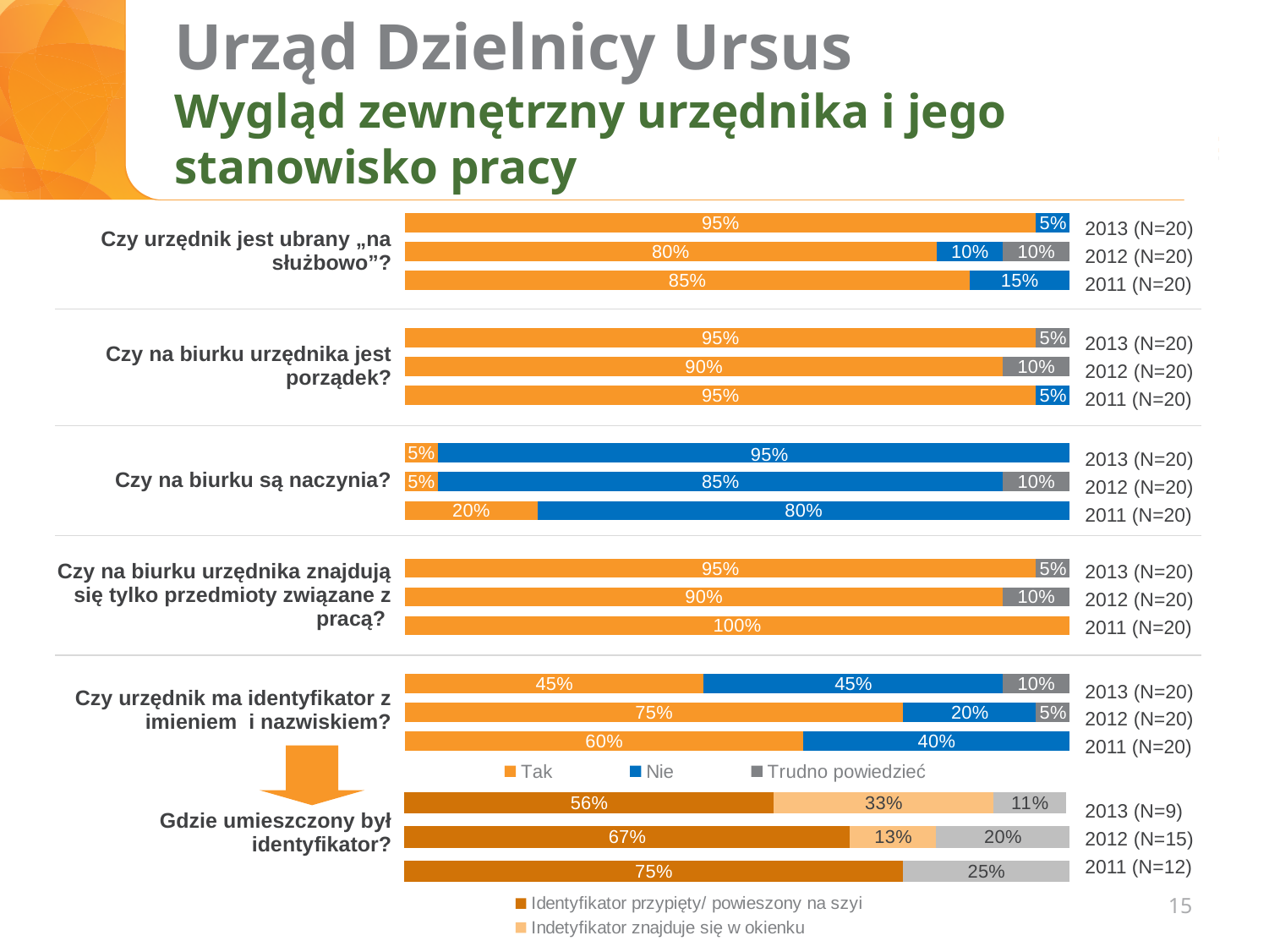
In the chart for "Gdzie umieszczony był identyfikator?", which year has the lowest value for "Identyfikator przypięty/ powieszony na szyi"? 2013 (N=9) In the chart for "Gdzie umieszczony był identyfikator?", what is the value for "Identyfikator przypięty/ powieszony na szyi" in 2012 (N=15)? 67% In the chart for "Czy urzędnik ma identyfikator z imieniem i nazwiskiem?", what is the difference between the "Tak" values for 2012 (N=20) and 2013 (N=20)? 30% In the chart for "Czy na biurku są naczynia?", which year has the highest "Tak" value? 2011 (N=20) How many series does the legend list for the "Czy urzędnik ma identyfikator z imieniem i nazwiskiem?" chart? 3 What kind of chart is used for "Czy na biurku urzędnika jest porządek?"? Stacked bar chart In the chart for "Czy urzędnik ma identyfikator z imieniem i nazwiskiem?", what is the "Nie" value for 2011 (N=20)? 40% In the chart for "Czy na biurku urzędnika jest porządek?", what is the "Tak" value for 2012 (N=20)? 90% In the chart for "Czy na biurku urzędnika znajdują się tylko przedmioty związane z pracą?", what is the "Tak" value for 2011 (N=20)? 100% In the chart for "Czy na biurku są naczynia?", what is the "Nie" value for 2011 (N=20)? 80% In the chart for "Czy urzędnik jest ubrany „na służbowo”?", what is the "Nie" value for 2011 (N=20)? 15% In the chart for "Czy urzędnik jest ubrany „na służbowo”?", what is the "Tak" value for 2013 (N=20)? 95%